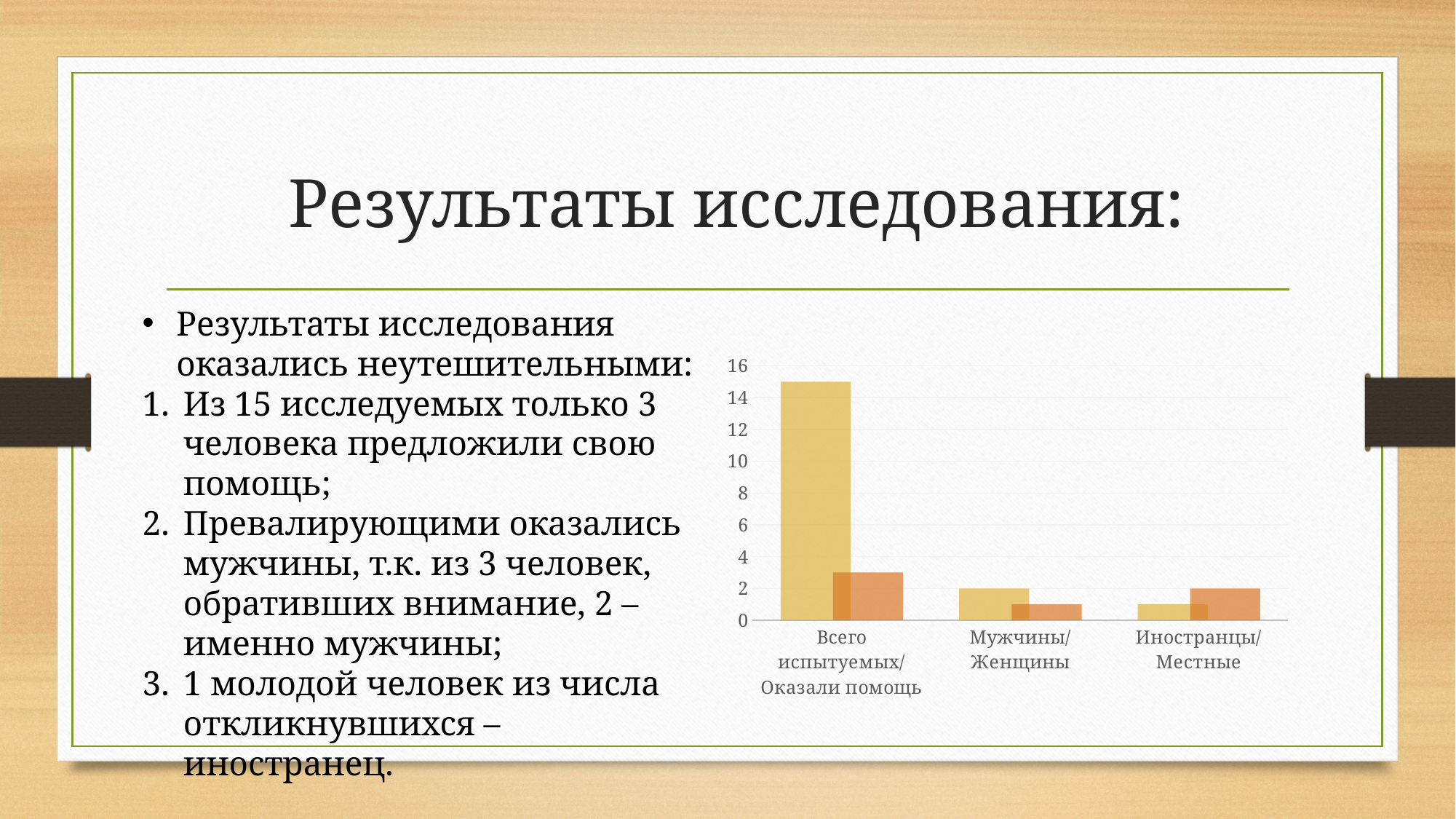
What is the value of the orange bar for Иностранцы/Местные? 2 Is the value of the orange bar for Всего испытуемых/Оказали помощь greater or less than 4? less Is the value of the yellow bar for Всего испытуемых/Оказали помощь greater or less than 14? greater In the Иностранцы/Местные category, which bar is taller, the yellow one or the orange one? the orange one What is the value of the yellow bar for Мужчины/Женщины? 2 Is the value of the orange bar for Мужчины/Женщины greater or less than 2? less In the Мужчины/Женщины category, which bar is taller, the yellow one or the orange one? the yellow one How many categories are shown on the x axis of the chart? 3 Does the chart include a legend? No Which category has the tallest bar in the chart? Всего испытуемых/Оказали помощь What is the highest value shown on the vertical axis of the chart? 16 What kind of chart is shown on the slide? bar chart